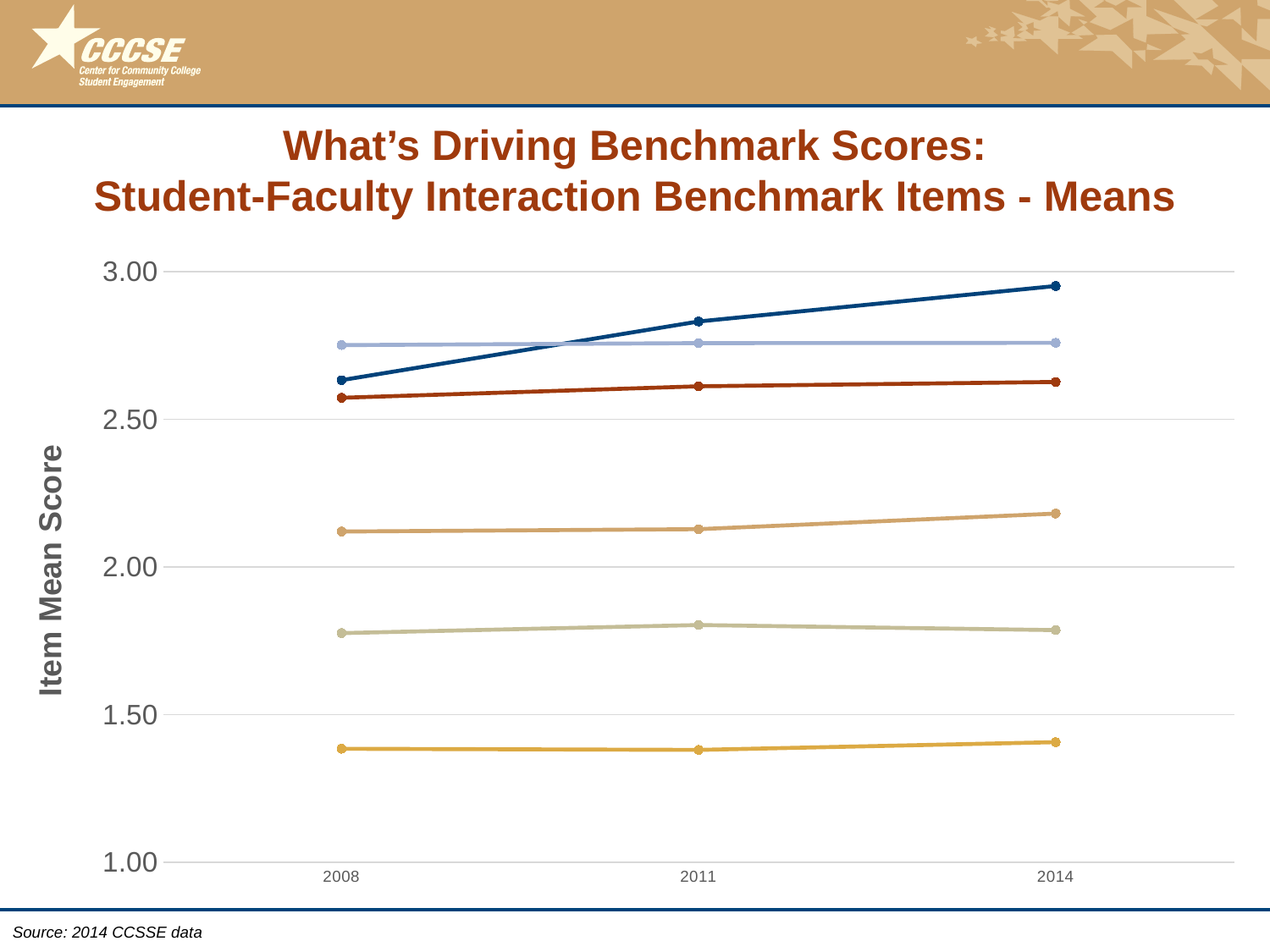
What is the label of the y axis? Item Mean Score Is the value of the tan line in 2014 greater or less than 2.00? greater Which line has the highest value in 2014? The dark blue line Is the value of the dark blue line in 2014 greater or less than 2.50? greater What kind of chart is shown on the slide? Line chart How many lines are plotted on the chart? 6 Is the value of the gold (lowest) line in 2011 greater or less than 1.50? less Which years are shown on the x axis of the chart? 2008, 2011, 2014 How many years are shown along the x axis of the chart? 3 Does the dark blue line rise or fall from 2008 to 2014? Rises